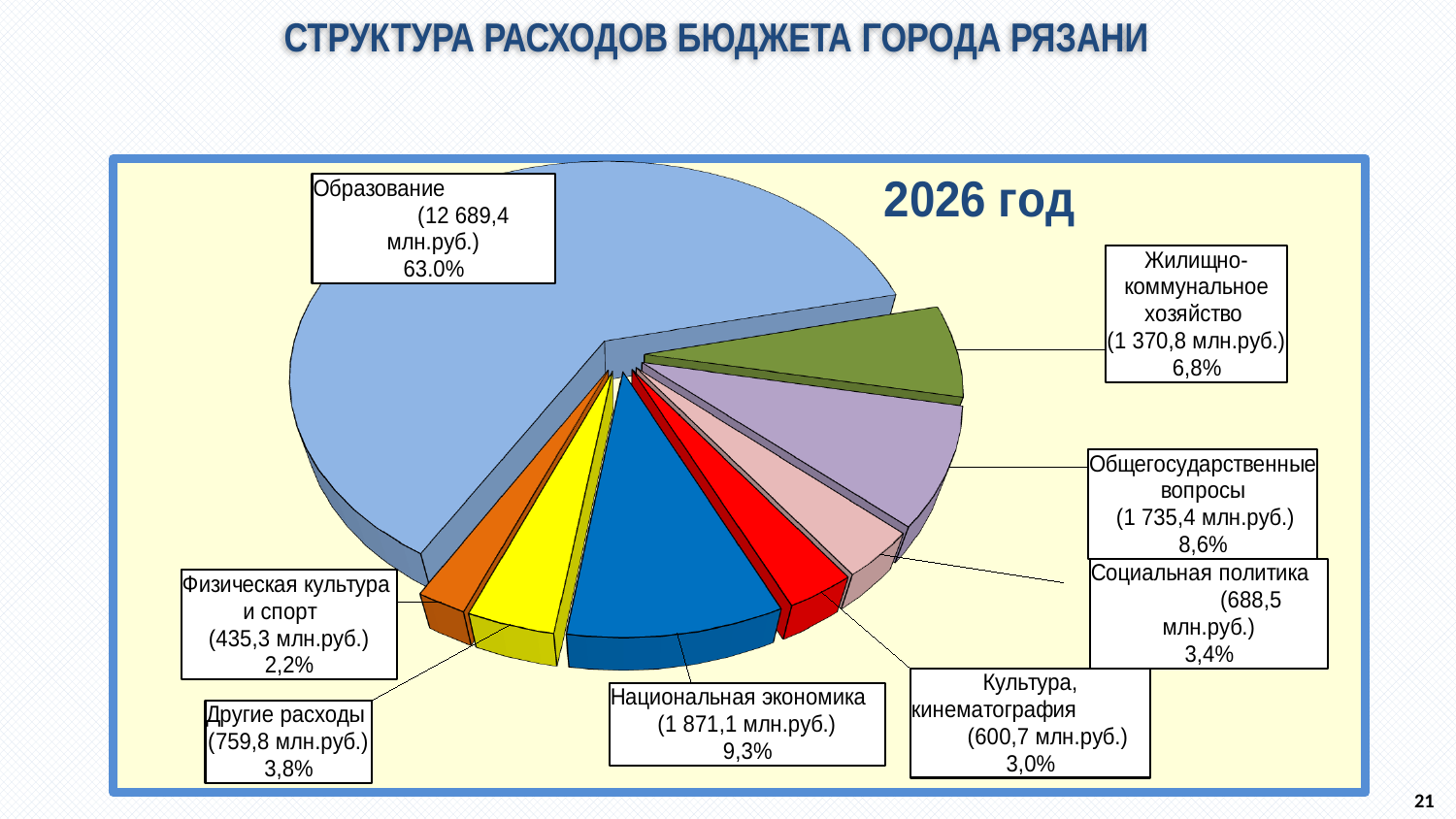
Which category has the smallest share of the budget expenditure? Физическая культура и спорт Which category has the largest share of the budget expenditure? Образование What is the difference in percentage points between Другие расходы (3,8%) and Культура, кинематография (3,0%)? 0,8% What is the title of the slide? СТРУКТУРА РАСХОДОВ БЮДЖЕТА ГОРОДА РЯЗАНИ What percentage share does Социальная политика have? 3,4% What type of chart is shown on the slide? Pie chart What share of the budget expenditure does Образование account for? 63.0% What year is shown on the chart? 2026 год What is the value in млн.руб. for Жилищно-коммунальное хозяйство? 1 370,8 млн.руб. What is the value in млн.руб. for Национальная экономика? 1 871,1 млн.руб. How many categories are shown in the pie chart? 8 Which is larger: Общегосударственные вопросы or Национальная экономика? Национальная экономика